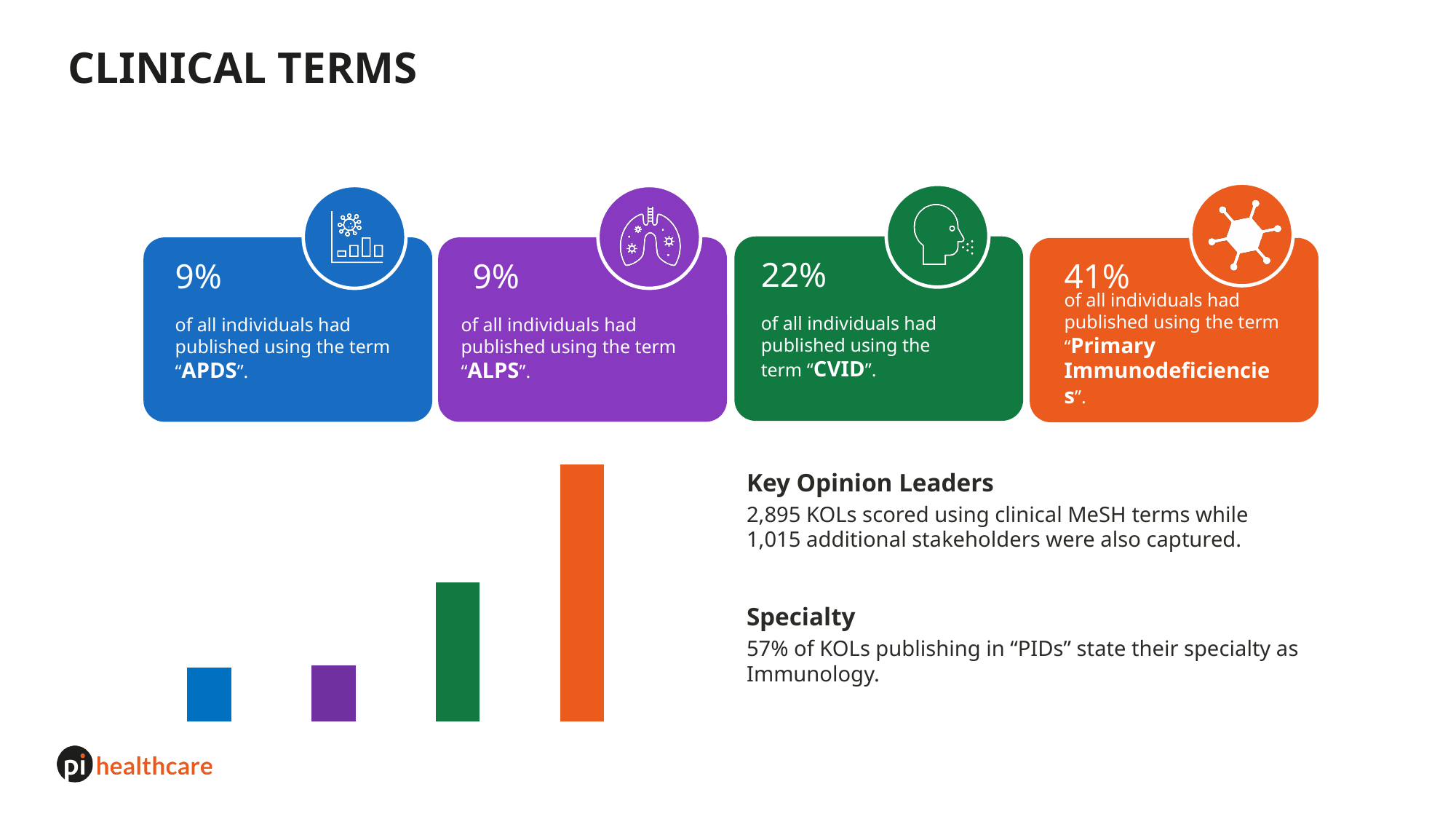
Which colour bar is the tallest in the bar chart? orange How many bars does the bar chart at the bottom left of the slide contain? 4 What is the difference in percentage points between the share publishing using "Primary Immunodeficiencies" and the share using "CVID"? 19 Which colour is used for the bar and box representing the term "ALPS"? purple What percentage of all individuals had published using the term "Primary Immunodeficiencies"? 41% What percentage of all individuals had published using the term "CVID"? 22% What percentage of all individuals had published using the term "APDS"? 9% Do the bar heights rise or fall from left to right in the bar chart? rise Which clinical term has the highest percentage of individuals publishing with it? Primary Immunodeficiencies What kind of chart is shown at the bottom left of the slide? bar chart Is the green bar taller or shorter than the purple bar in the bar chart? taller Is the orange bar taller or shorter than the green bar in the bar chart? taller